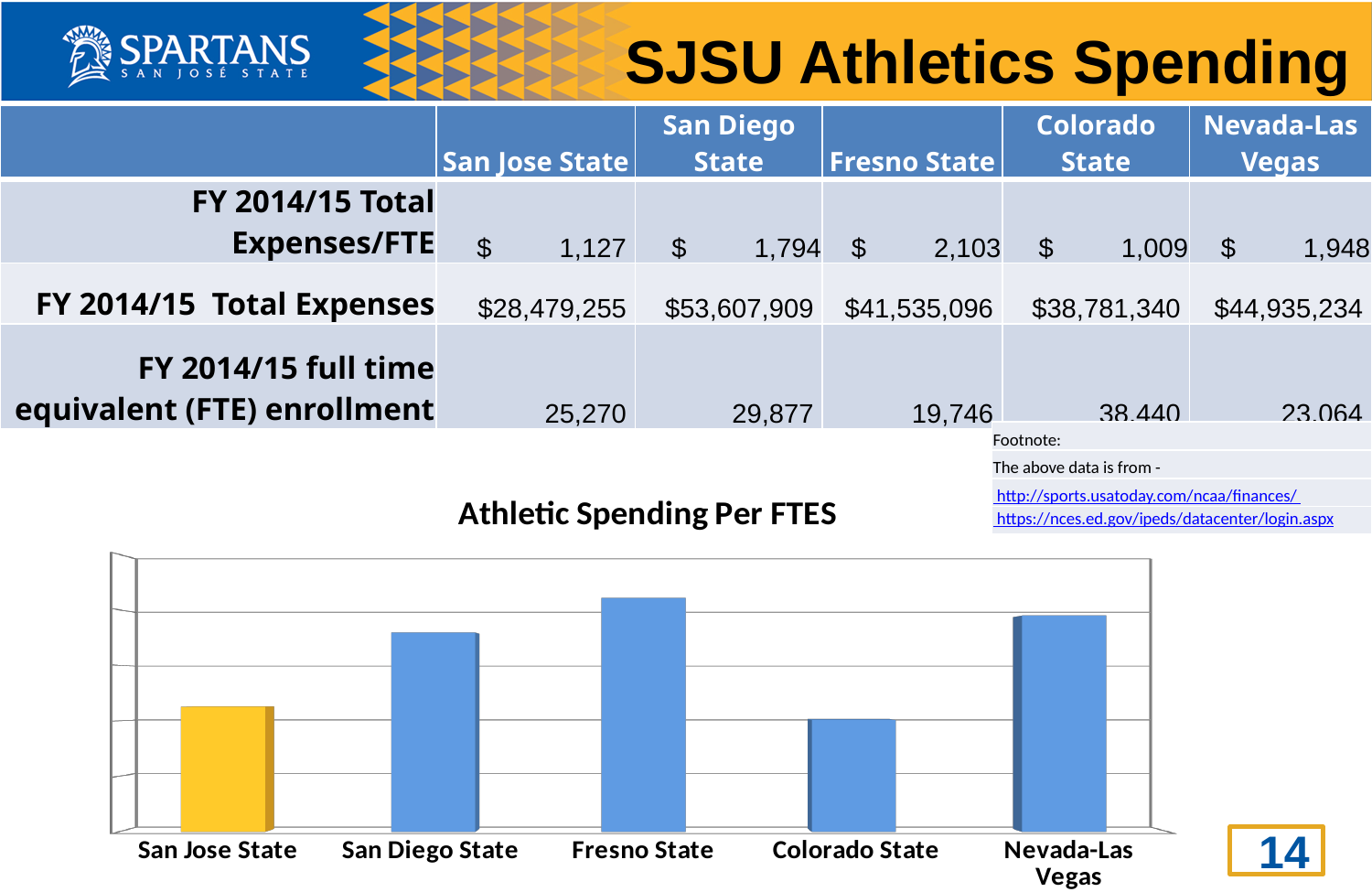
Which university has the shortest bar in the "Athletic Spending Per FTES" chart? Colorado State In the "Athletic Spending Per FTES" chart, which bar is taller: Fresno State or Nevada-Las Vegas? Fresno State How many universities are plotted in the "Athletic Spending Per FTES" chart? 5 Which bar in the "Athletic Spending Per FTES" chart is coloured differently (gold) from the others? San Jose State Which university has the tallest bar in the "Athletic Spending Per FTES" chart? Fresno State According to the table, what is the FY 2014/15 Total Expenses/FTE for Colorado State, the value plotted in the chart? $1,009 According to the table, what is the FY 2014/15 Total Expenses/FTE for Fresno State, the value plotted in the chart? $2,103 According to the table, what is the FY 2014/15 Total Expenses/FTE for San Jose State, the value plotted in the chart? $1,127 In the "Athletic Spending Per FTES" chart, which bar is taller: San Diego State or Nevada-Las Vegas? Nevada-Las Vegas Using the table values, what is the difference in FY 2014/15 Total Expenses/FTE between Fresno State and Colorado State? $1,094 What type of chart is shown under the title "Athletic Spending Per FTES"? bar chart What is the title of the bar chart on the slide? Athletic Spending Per FTES